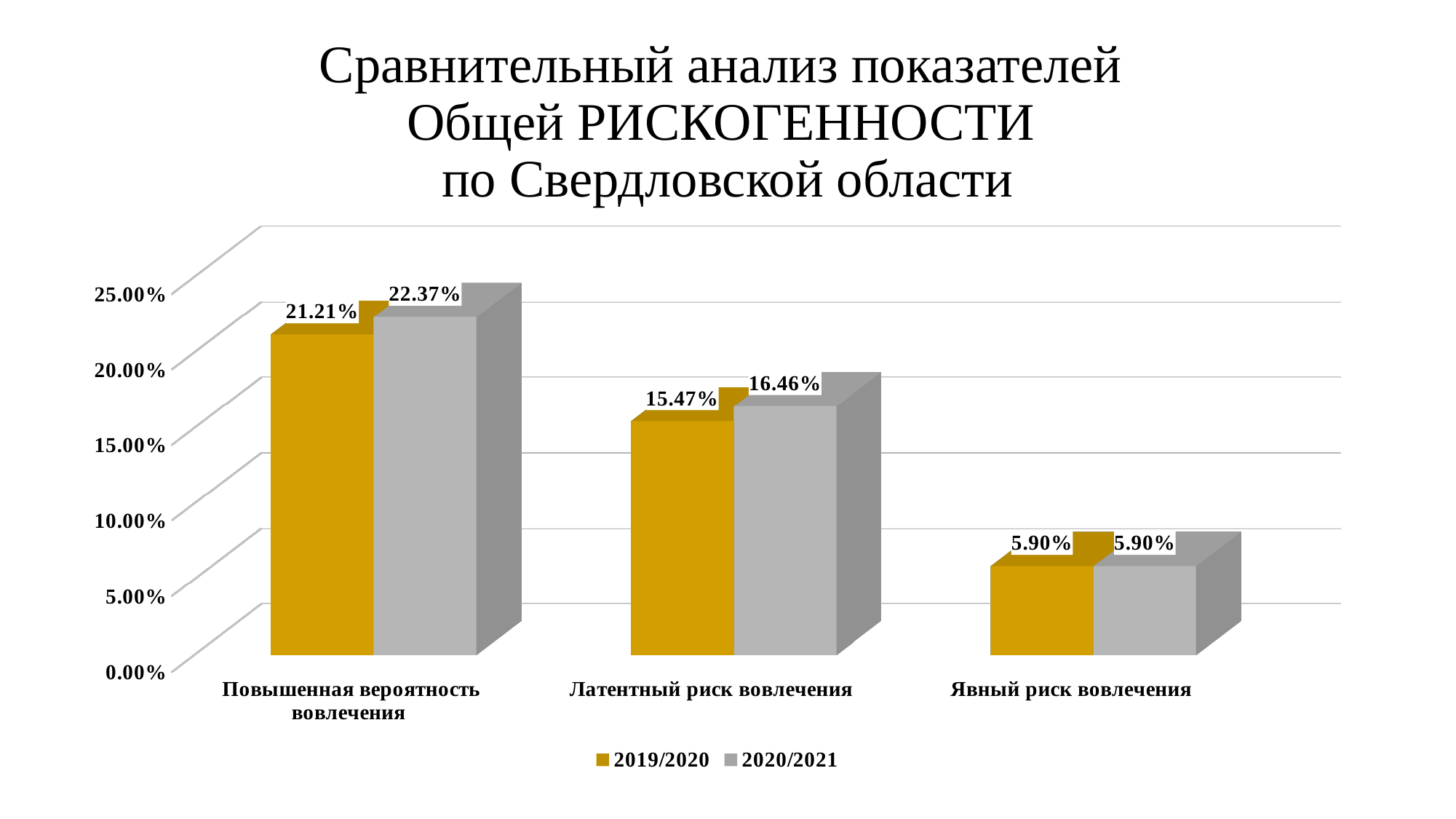
Which is larger for "Латентный риск вовлечения": the 2019/2020 value or the 2020/2021 value? 2020/2021 What kind of chart is shown on the slide? Bar chart How many series does the legend list? 2 What is the value for 2019/2020 in the category "Явный риск вовлечения"? 5.90% How many categories are shown on the x axis? 3 What is the difference between the 2020/2021 and 2019/2020 values for "Повышенная вероятность вовлечения"? 1.16% Which category has the highest value for 2020/2021? Повышенная вероятность вовлечения What is the value for 2019/2020 in the category "Повышенная вероятность вовлечения"? 21.21% What is the value for 2020/2021 in the category "Латентный риск вовлечения"? 16.46% What is the difference between the 2020/2021 and 2019/2020 values for "Латентный риск вовлечения"? 0.99% Which category has the lowest value for 2019/2020? Явный риск вовлечения Is the 2020/2021 value for "Повышенная вероятность вовлечения" greater or less than 20.00%? greater